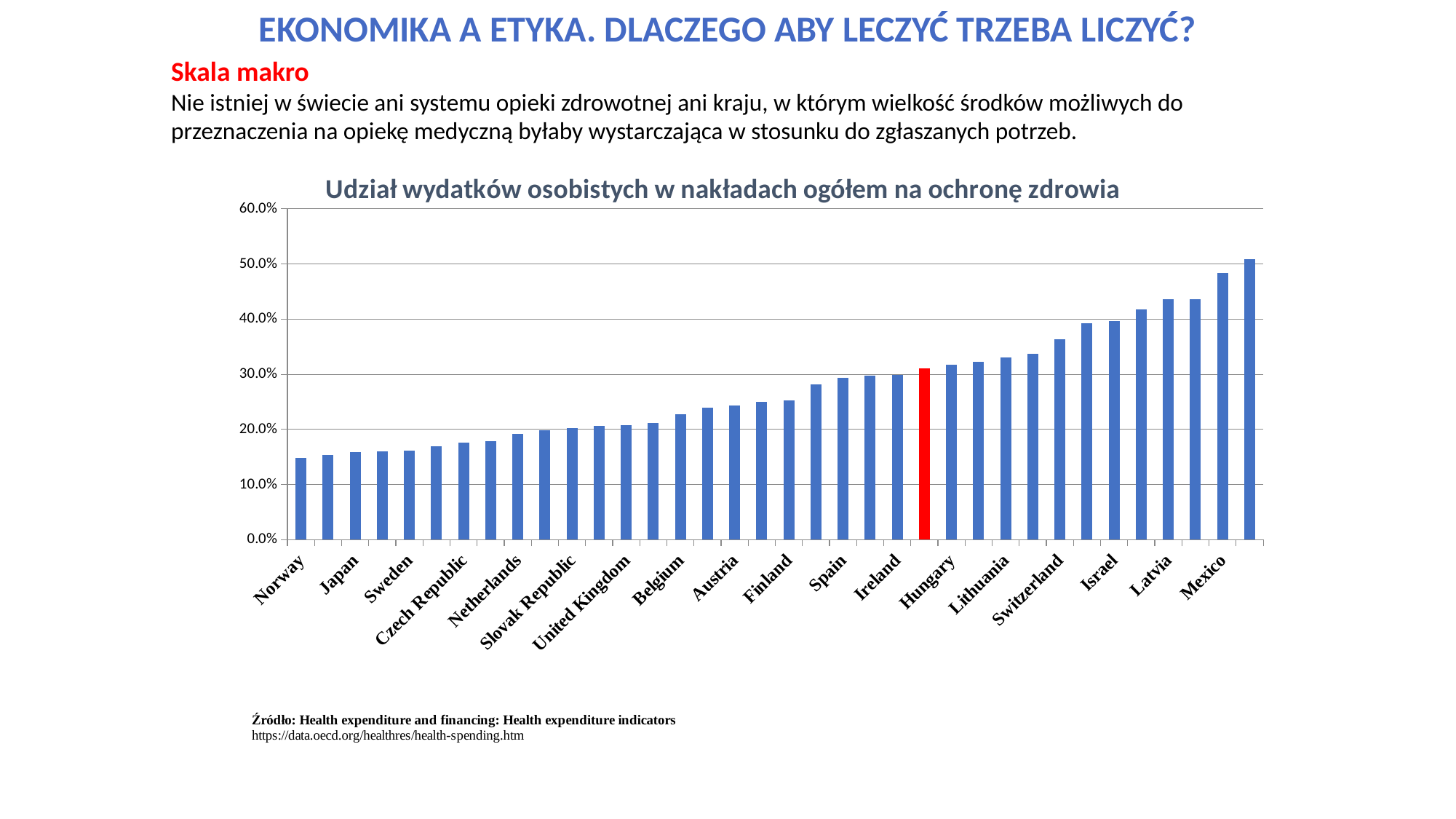
Is the value for Switzerland greater or less than 30.0%? greater Do the values generally rise or fall from left to right along the x axis? rise Which has the larger value, Mexico or Norway? Mexico Is the value for Czech Republic greater or less than 20.0%? less Is the value for Finland greater or less than 30.0%? less What colour is the single highlighted bar in the chart? red What is the title of the chart? Udział wydatków osobistych w nakładach ogółem na ochronę zdrowia Which has the larger value, Switzerland or Belgium? Switzerland What kind of chart is shown on the slide? bar chart